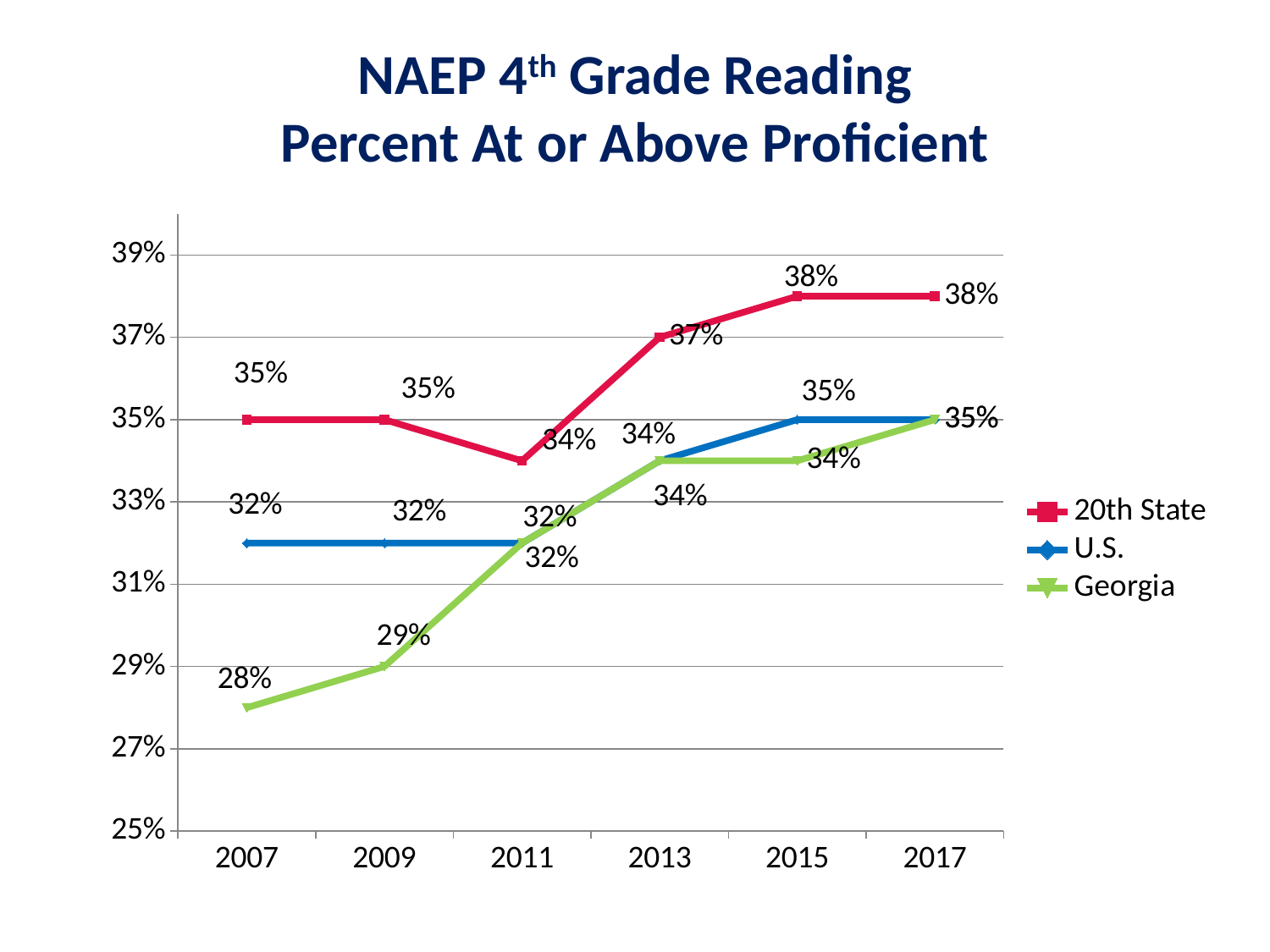
What was the 20th State value in 2015? 38% How many years are plotted along the x axis? 6 What type of chart is shown on the slide? Line chart Which was higher in 2015, the U.S. value or Georgia's value? U.S. In which year was Georgia's value lowest? 2007 What was Georgia's percent at or above proficient in 2007? 28% What is the difference between the 20th State value and Georgia's value in 2007? 7 percentage points What was Georgia's value in 2009? 29% Which series is shown in red? 20th State What was the U.S. value in 2013? 34% Does Georgia's line generally rise or fall from 2007 to 2017? Rise How many series does the legend list? 3